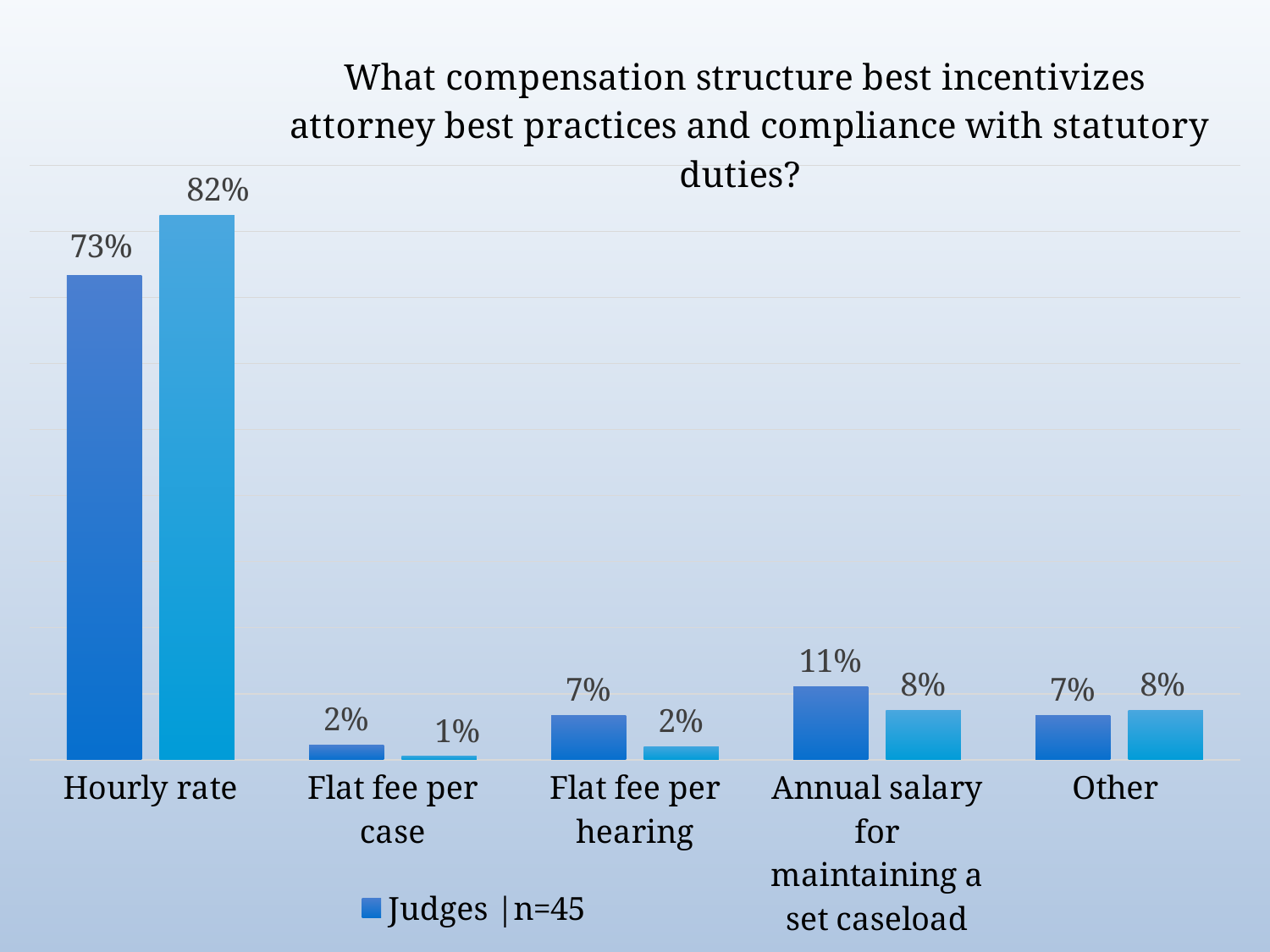
What is the Judges |n=45 value for Annual salary for maintaining a set caseload? 11% What is the Judges |n=45 value for Hourly rate? 73% What is the difference between the Judges |n=45 values for Hourly rate and Annual salary for maintaining a set caseload? 62% What is the difference between the Judges |n=45 values for Flat fee per hearing and Flat fee per case? 5% How many series does the legend list? 1 How many categories are shown on the x axis? 5 Which category has the highest Judges |n=45 value? Hourly rate Which category has the lowest Judges |n=45 value? Flat fee per case What is the Judges |n=45 value for Flat fee per case? 2% What is the Judges |n=45 value for Other? 7% What kind of chart is shown on the slide? Bar chart For Judges |n=45, which is larger: Annual salary for maintaining a set caseload or Flat fee per hearing? Annual salary for maintaining a set caseload